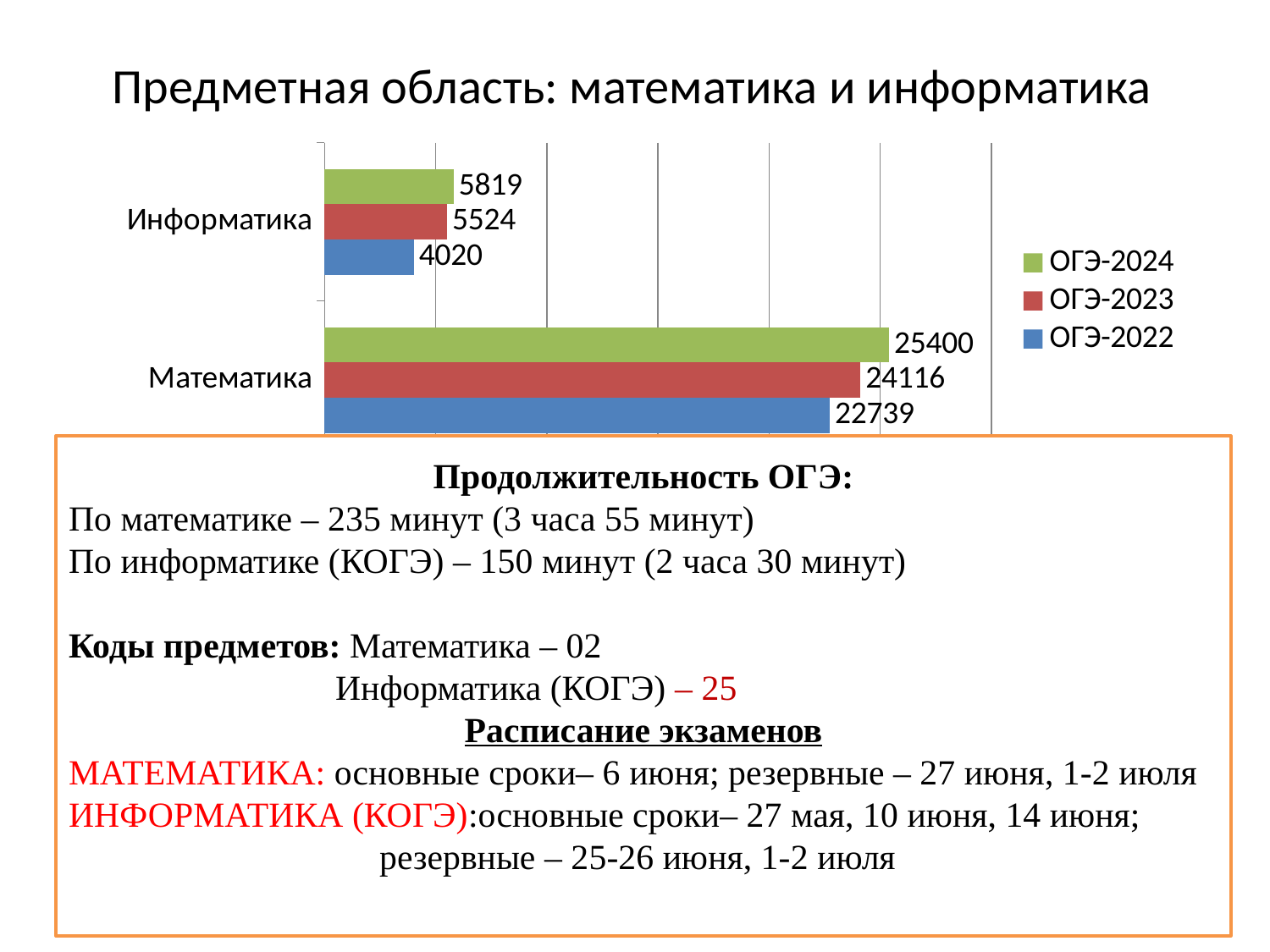
How many series does the legend list? 3 What is the value for Информатика in the ОГЭ-2023 series? 5524 What is the difference between the ОГЭ-2024 and ОГЭ-2023 values for Информатика? 295 What is the difference between the ОГЭ-2024 and ОГЭ-2022 values for Математика? 2661 Which series has the lowest value for Информатика? ОГЭ-2022 What is the value for Математика in the ОГЭ-2024 series? 25400 Which series has the highest value for Математика? ОГЭ-2024 What kind of chart is shown on the slide? Bar chart What is the value for Информатика in the ОГЭ-2022 series? 4020 Which is larger: the ОГЭ-2023 value for Математика or the ОГЭ-2022 value for Математика? ОГЭ-2023 What is the value for Математика in the ОГЭ-2022 series? 22739 How many categories are shown on the chart? 2